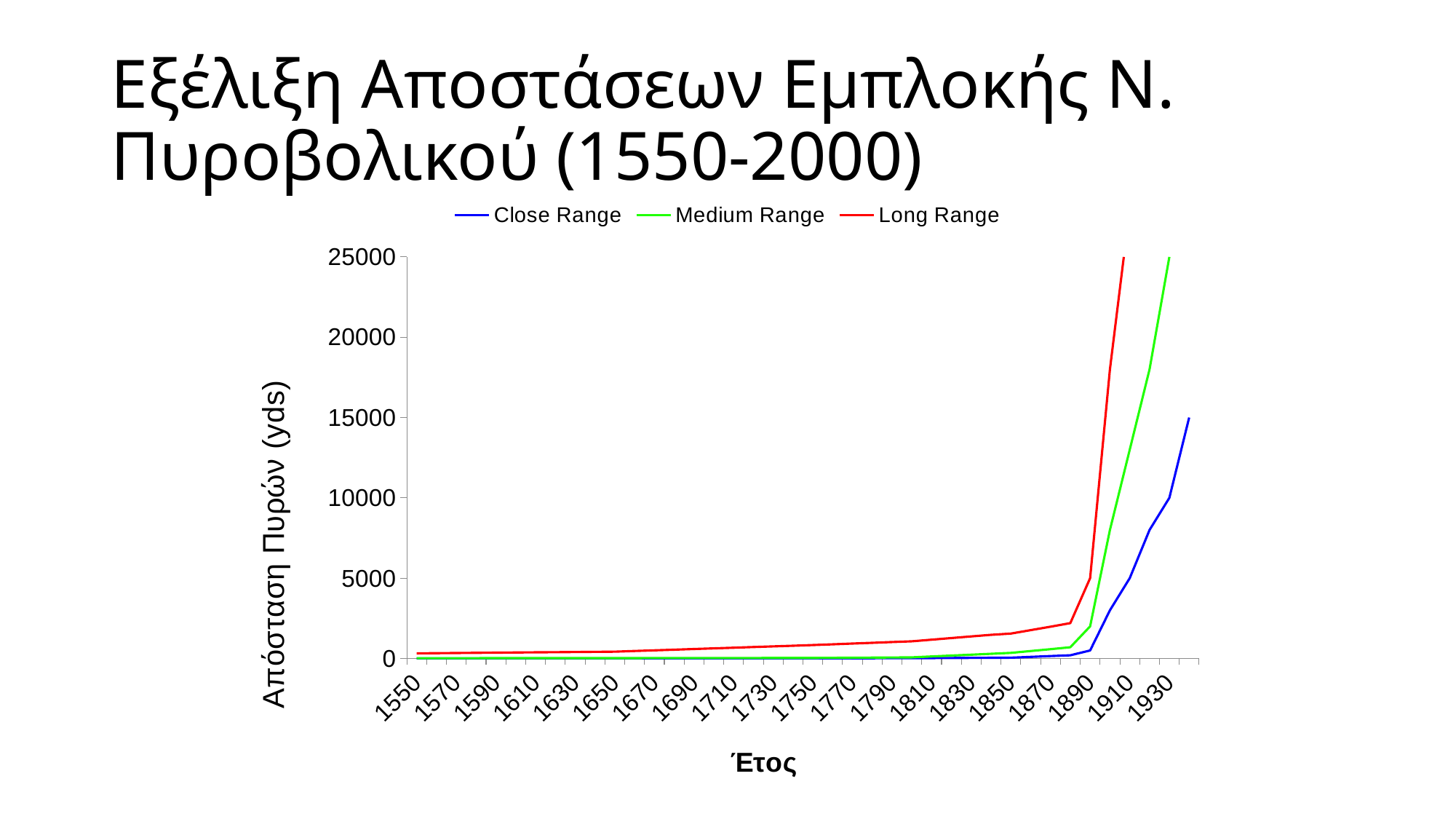
Is the value for Medium Range at 1930 greater or less than 15000? greater Is the value for Long Range at 1850 greater or less than 5000? less Do the values of the Long Range series rise or fall as the years increase along the x axis? rise Which series has the lowest values across the whole chart? Close Range Which series has the highest value at 1890? Long Range How many series does the legend list? 3 At 1870, which is larger: the Long Range value or the Close Range value? Long Range What is the title of the x axis? Έτος What kind of chart is shown on the slide? line chart Is the value for Close Range at 1890 greater or less than 5000? less What are the three series named in the legend? Close Range, Medium Range, Long Range